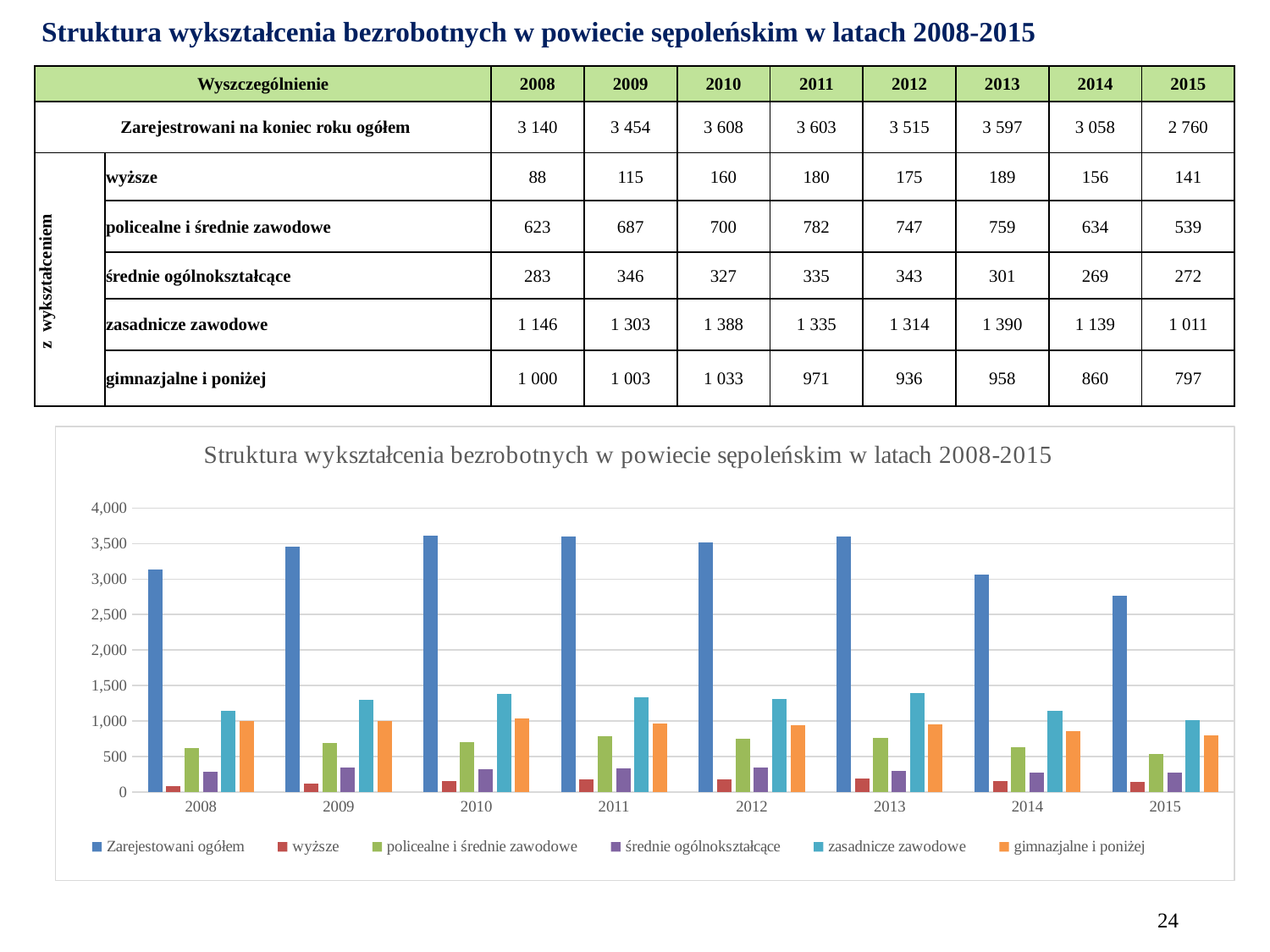
How many years are shown along the x axis of the chart? 8 Is the value for Zarejestrowani ogółem in 2015 greater or less than 3,000? less What is the difference between the value for wyższe in 2011 and in 2008? 92 In which year is the value for wyższe the highest? 2013 Is the value for zasadnicze zawodowe in 2013 greater or less than 1,000? greater What is the value of gimnazjalne i poniżej for 2015? 797 What kind of chart is shown on the slide? bar chart How many series does the chart legend list? 6 In 2009, which is larger: policealne i średnie zawodowe or gimnazjalne i poniżej? gimnazjalne i poniżej In which year is Zarejestrowani ogółem the lowest? 2015 What is the value of Zarejestrowani na koniec roku ogółem for 2010? 3 608 Does the value for Zarejestrowani ogółem rise or fall from 2013 to 2015? fall